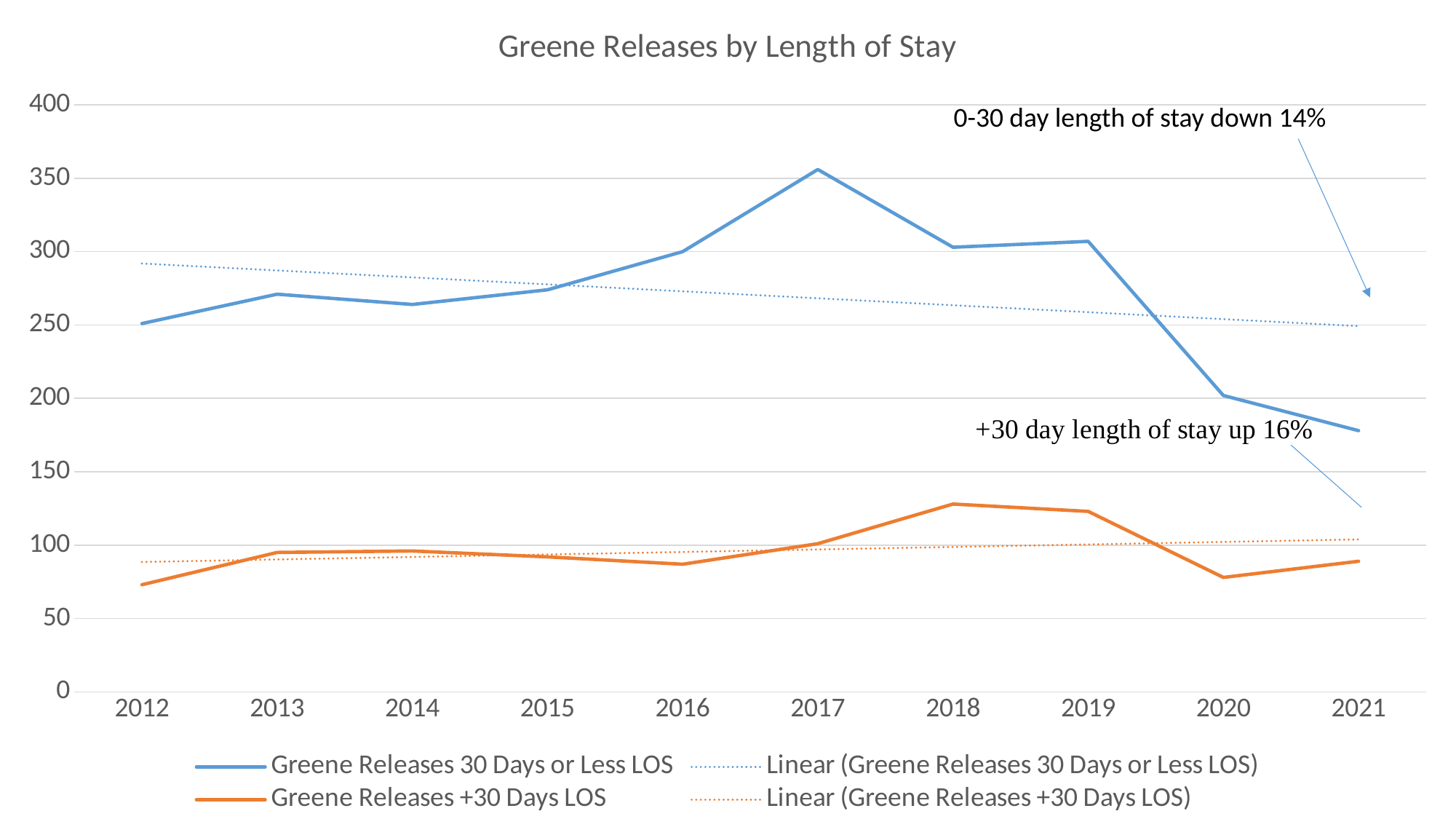
According to the annotation on the chart, by what percentage is the 0-30 day length of stay down? 14% How many years are shown on the x axis? 10 How many entries does the legend list? 4 What is the title of the chart? Greene Releases by Length of Stay Does the Greene Releases 30 Days or Less LOS line rise or fall from 2019 to 2021? fall Is the value for Greene Releases 30 Days or Less LOS in 2021 greater or less than 200? less In which year is the value for Greene Releases 30 Days or Less LOS highest? 2017 What kind of chart is shown on the slide? line chart Which is larger for Greene Releases +30 Days LOS, the value in 2018 or the value in 2016? 2018 In which year is the value for Greene Releases 30 Days or Less LOS lowest? 2021 Is the value for Greene Releases 30 Days or Less LOS in 2017 greater or less than 300? greater Is the value for Greene Releases +30 Days LOS in 2018 greater or less than 100? greater